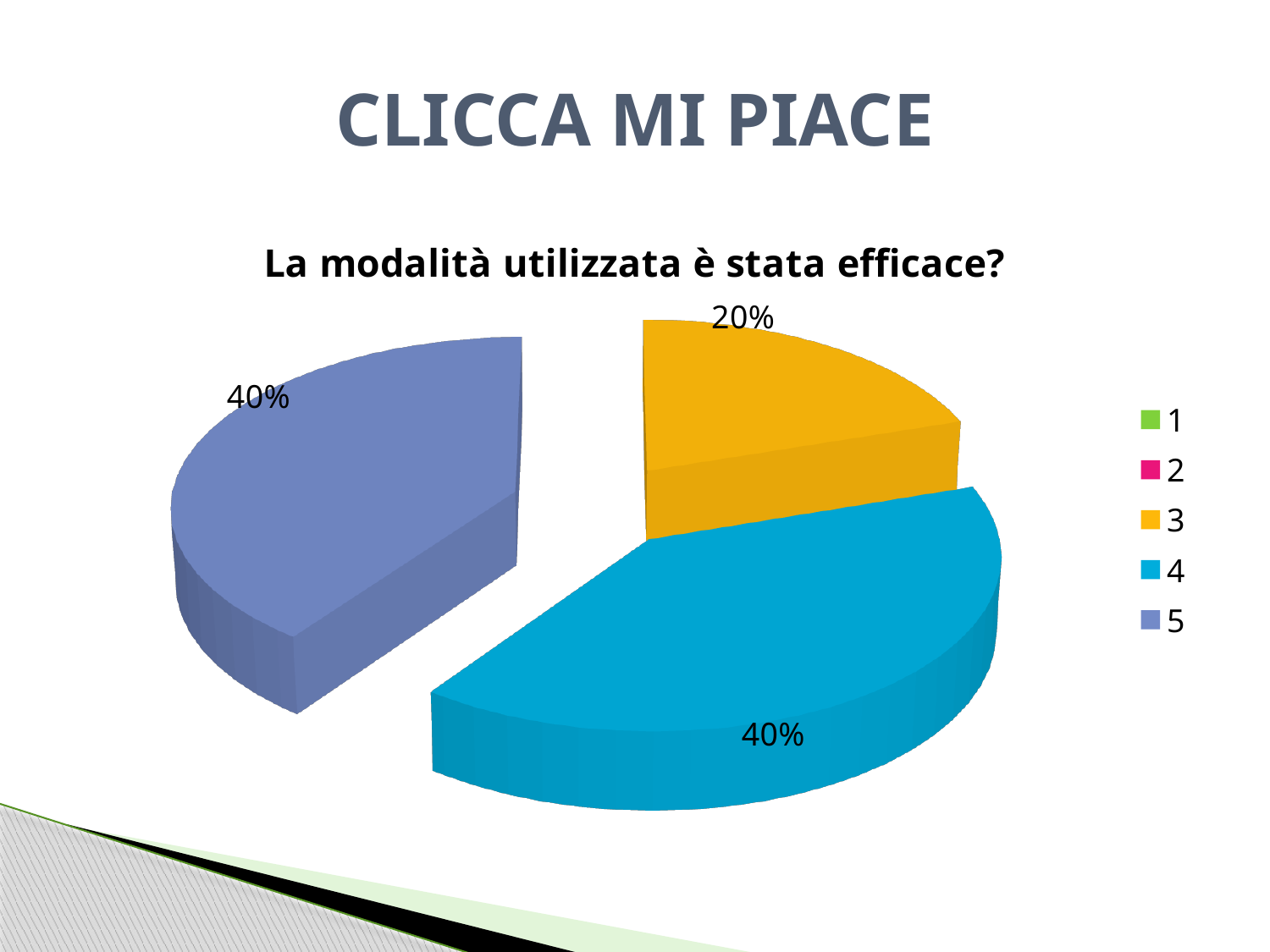
How many entries does the legend list? 5 What percentage of the pie does category 3 represent? 20% What is the difference in percentage points between the slice for category 4 and the slice for category 3? 20% What percentage of the pie does category 4 represent? 40% What percentage of the pie does category 5 represent? 40% Is the slice for category 5 greater or less than 30%? greater What kind of chart is shown on the slide? pie chart How many slices are visible in the pie? 3 Which category has the smallest slice shown in the pie? 3 Which is larger, the slice for category 3 or the slice for category 4? 4 Which legend entries are listed for the chart? 1, 2, 3, 4, 5 What is the title of the chart? La modalità utilizzata è stata efficace?